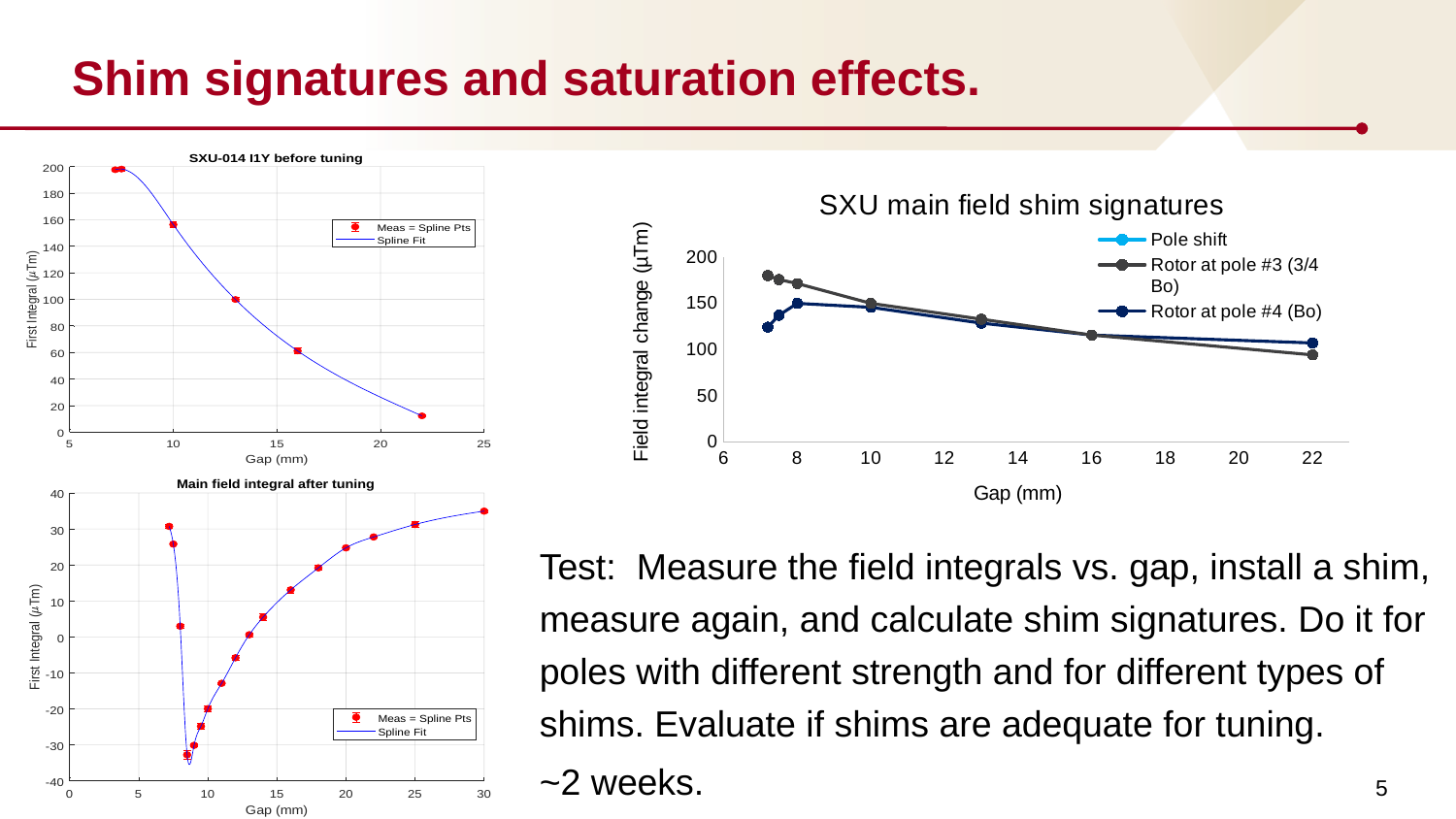
In the 'SXU main field shim signatures' chart, what is the label of the x axis? Gap (mm) In the 'SXU-014 I1Y before tuning' chart, does the first integral rise or fall as the gap increases? fall In the 'SXU main field shim signatures' chart, is the value for 'Rotor at pole #3 (3/4 Bo)' at the smallest gap greater or less than 150? greater In the 'SXU-014 I1Y before tuning' chart, is the measured value at a gap of about 16 mm greater or less than 80? less In the 'SXU main field shim signatures' chart, does the 'Rotor at pole #3 (3/4 Bo)' series rise or fall as the gap increases from 8 mm to 22 mm? fall In the 'SXU-014 I1Y before tuning' chart, is the measured value at a gap of about 22 mm greater or less than 20? less In the 'SXU main field shim signatures' chart, how many series does the legend list? 3 In the 'SXU main field shim signatures' chart, what kind of chart is it? Line chart In the 'Main field integral after tuning' chart, how many entries does the legend list? 2